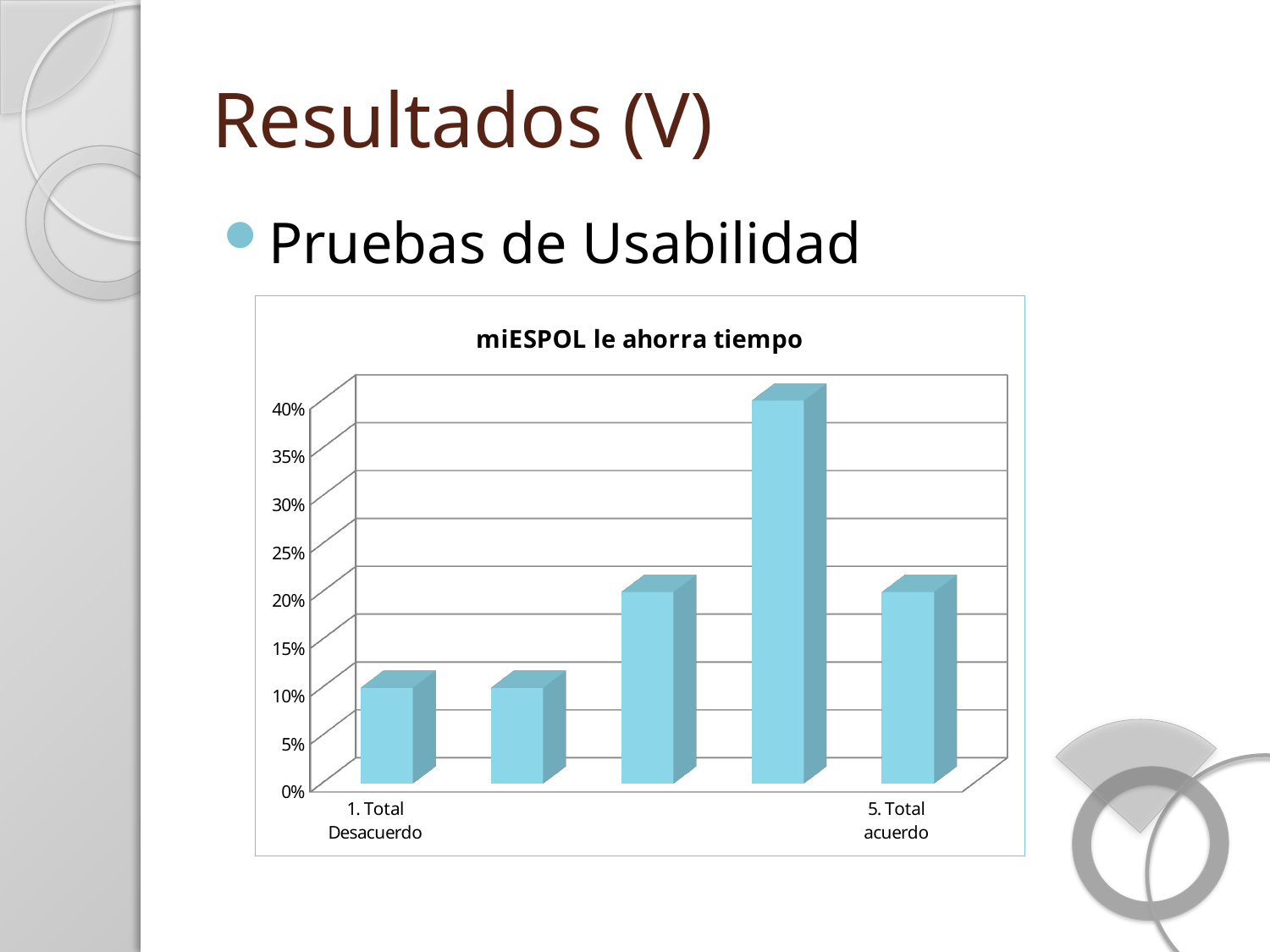
What is the title of the chart? miESPOL le ahorra tiempo What is the value for "5. Total acuerdo"? 20% What is the highest value shown on the vertical axis? 40% Which is larger, the value for "1. Total Desacuerdo" or the value for "5. Total acuerdo"? 5. Total acuerdo How many bars are plotted in the chart? 5 What is the difference between the value for "5. Total acuerdo" and the value for "1. Total Desacuerdo"? 10% Is the value for "1. Total Desacuerdo" greater or less than 15%? less What type of chart is shown on the slide? bar chart What is the value for "1. Total Desacuerdo"? 10% Is the value for "1. Total Desacuerdo" the lowest value in the chart? Yes Is the value for "5. Total acuerdo" greater or less than 15%? greater